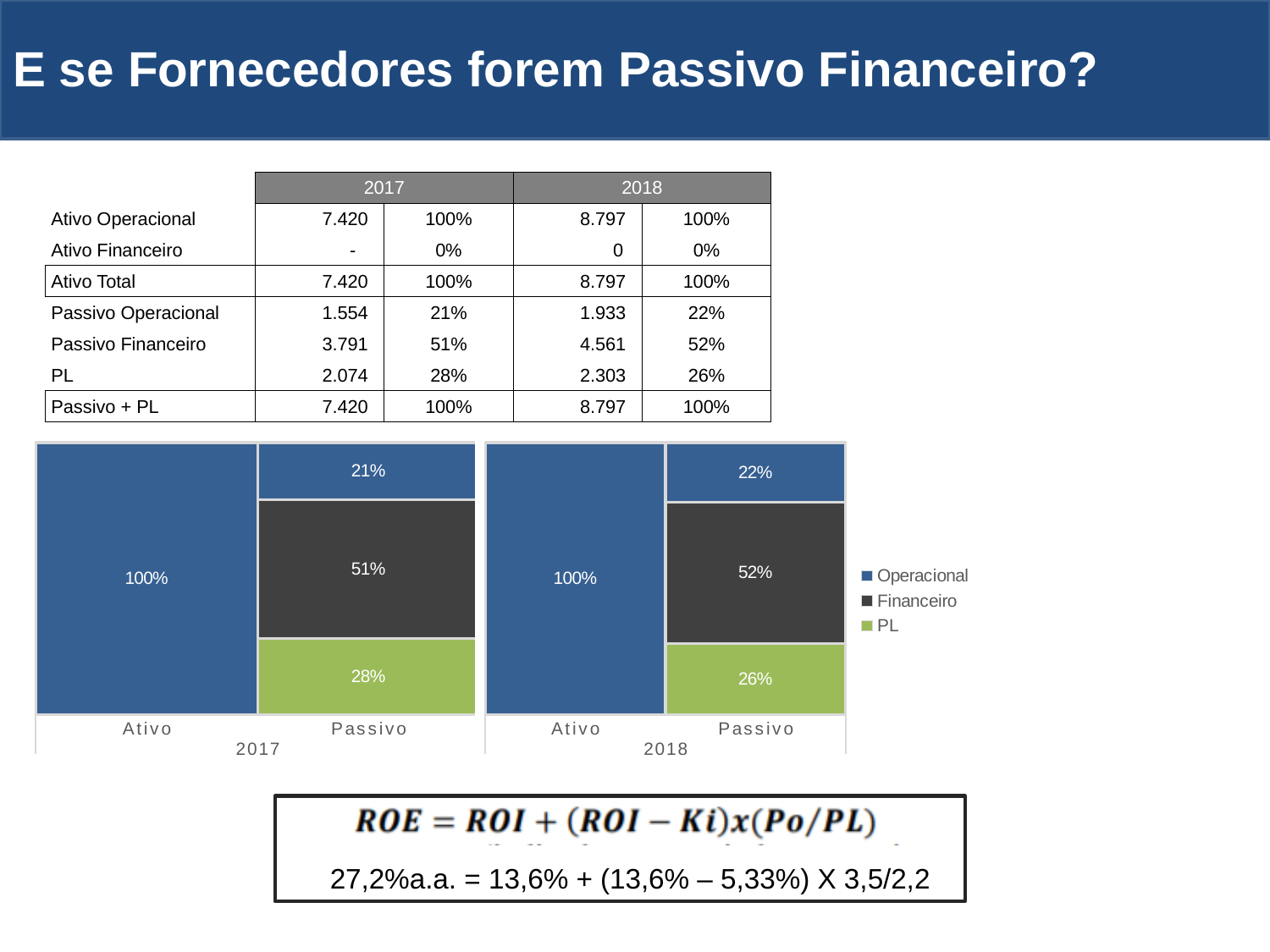
In the chart, what is the PL share of the Passivo bar for 2017? 28% In the chart, what is the value shown on the Ativo bar for 2018? 100% In the chart, what is the Financeiro share of the Passivo bar for 2018? 52% What kind of chart is shown on the slide? stacked bar chart In the chart, which segment of the 2018 Passivo bar is the largest? Financeiro In the chart, what is the Operacional share of the Passivo bar for 2017? 21% How many series does the chart legend list? 3 Which series are listed in the chart legend? Operacional, Financeiro, PL In the chart, what is the difference between the Financeiro and PL shares of the Passivo bar for 2017? 23% In the chart, which segment of the 2017 Passivo bar is the smallest? Operacional How many bars are plotted in the chart in total? 4 In the chart, is the PL share of the Passivo bar larger in 2017 or in 2018? 2017